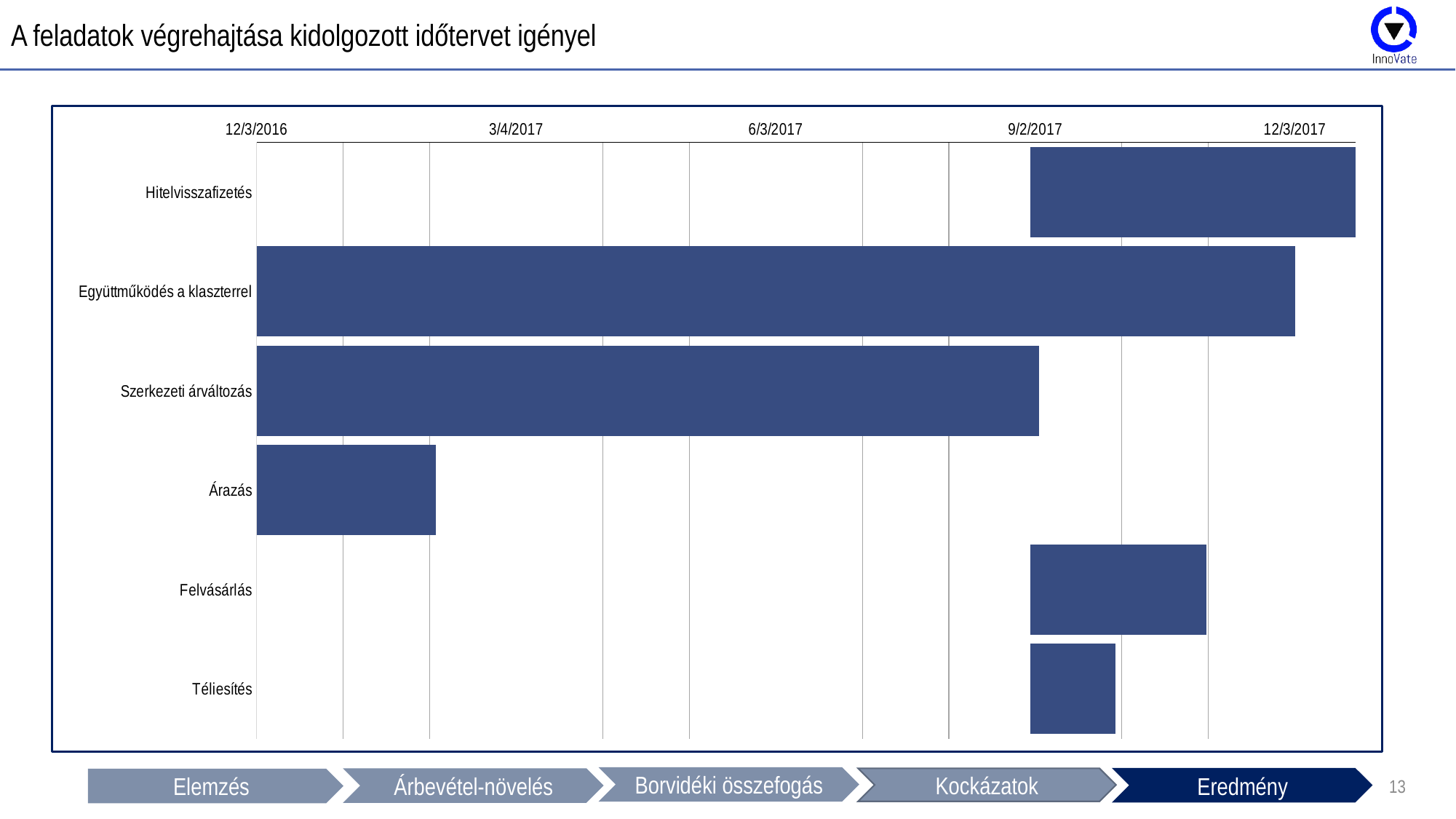
Which bar is longer, Szerkezeti árváltozás or Árazás? Szerkezeti árváltozás Which task has the longest bar in the chart? Együttműködés a klaszterrel What is the last date shown on the horizontal axis of the chart? 12/3/2017 What kind of chart is shown on the slide? Bar chart (Gantt chart) How many tasks are listed on the vertical axis of the chart? 6 What is the first date shown on the horizontal axis of the chart? 12/3/2016 Which bar is longer, Felvásárlás or Téliesítés? Felvásárlás Which task has the shortest bar in the chart? Téliesítés Which task is listed at the bottom of the chart? Téliesítés Does the bar for Árazás end before or after 3/4/2017? before